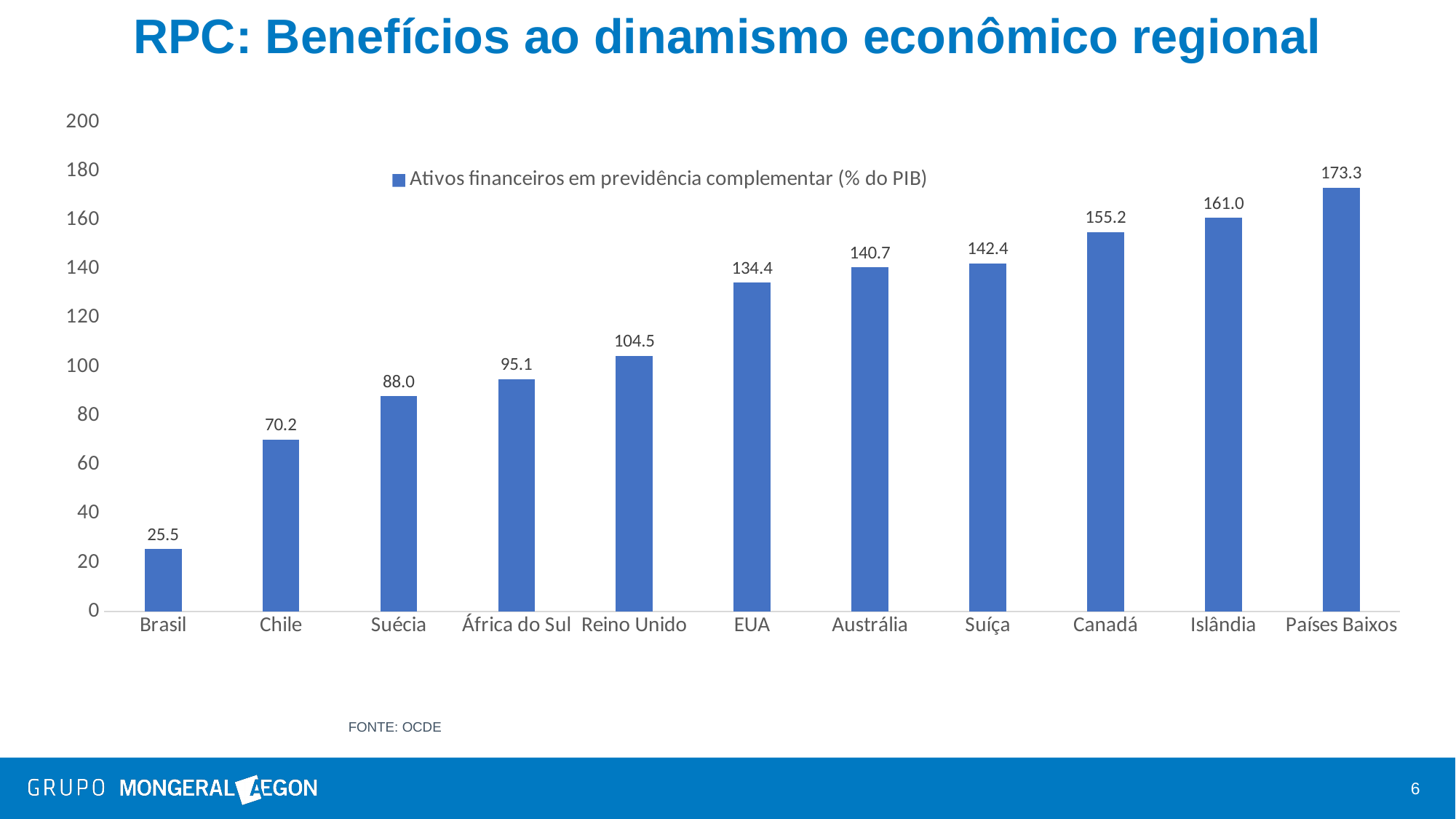
What is the value for Canadá? 155.2 What is the value for Reino Unido? 104.5 What is the value for Brasil? 25.5 What is the legend entry for the series shown? Ativos financeiros em previdência complementar (% do PIB) What is the difference between the values for Islândia and Suíça? 18.6 Which country has the lowest value? Brasil Which country has the highest value? Países Baixos How many countries are shown on the x axis? 11 What is the difference between the values for Chile and Brasil? 44.7 Which is larger, the value for EUA or the value for Austrália? Austrália Is the value for Suécia greater or less than 100? less What kind of chart is shown on the slide? bar chart